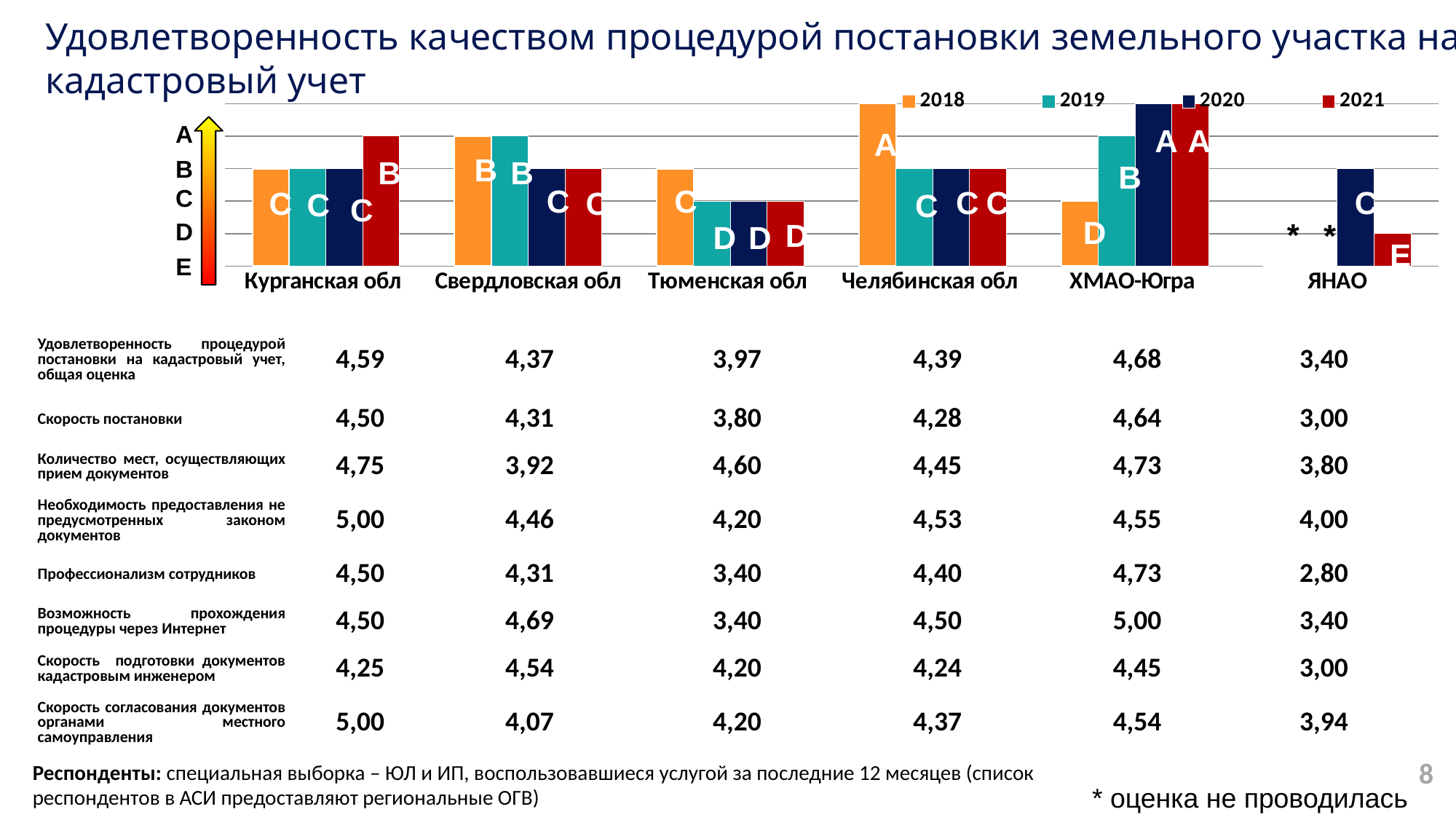
What grade did Челябинская обл receive in 2018? A Which region has the highest grade for 2021? ХМАО-Югра What does the asterisk shown for ЯНАО in 2018 and 2019 mean, according to the slide? оценка не проводилась How many years does the legend list? 4 How many regions are shown on the chart? 6 What grade did Тюменская обл receive in 2019? D Which region has the lowest grade for 2018 among those assessed? ХМАО-Югра What grade did ХМАО-Югра receive in 2018? D Did the grade for ХМАО-Югра rise or fall from 2018 to 2021? rise What grade did ЯНАО receive in 2021? E What grade did Курганская обл receive in 2021? B Which region has the lowest grade for 2021? ЯНАО